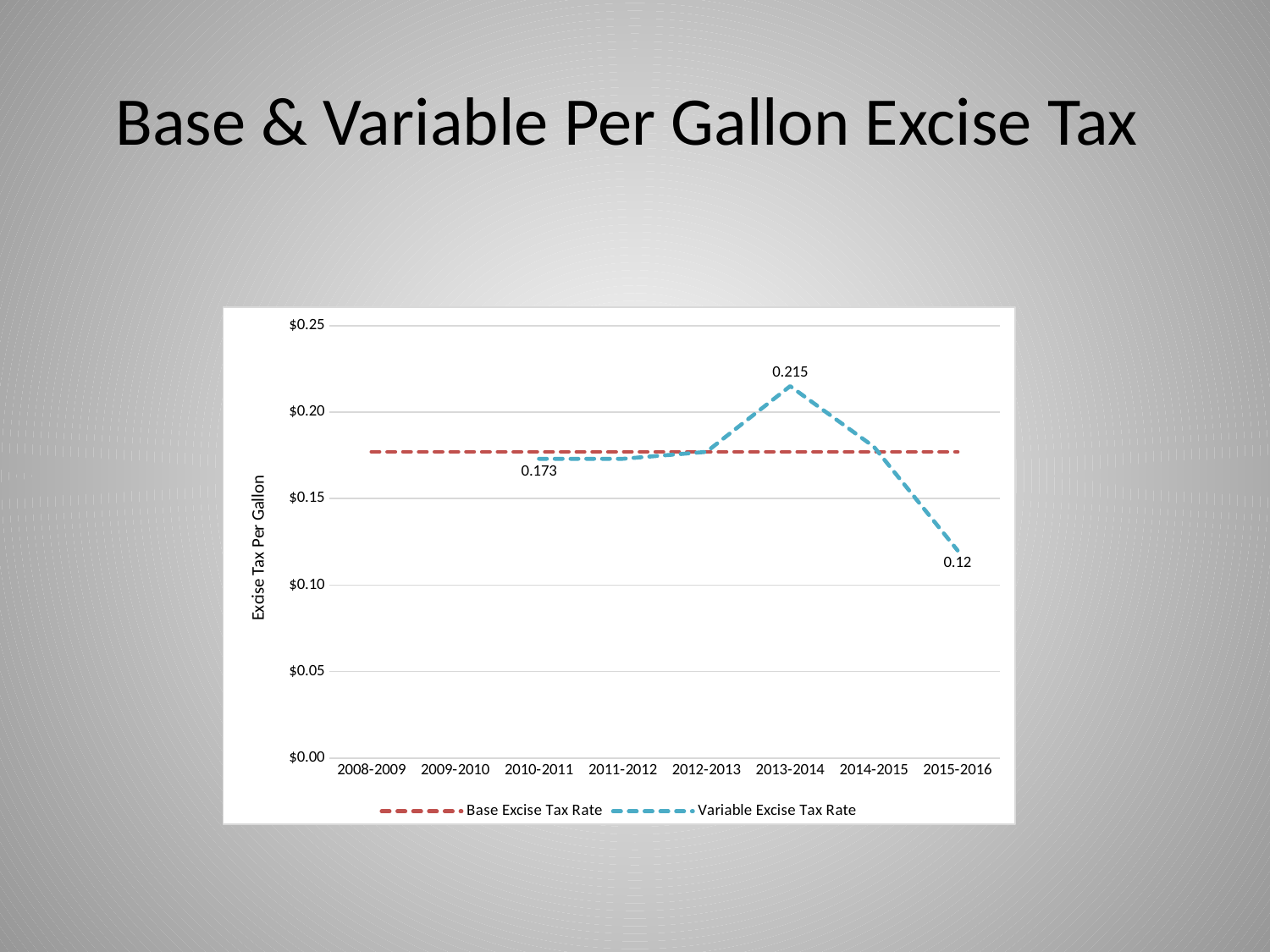
What is the Variable Excise Tax Rate for 2015-2016? 0.12 In which period is the Variable Excise Tax Rate highest? 2013-2014 Which is larger, the Variable Excise Tax Rate in 2010-2011 or in 2013-2014? 2013-2014 What is the Variable Excise Tax Rate for 2013-2014? 0.215 Is the Base Excise Tax Rate greater or less than $0.20? less How many periods are shown on the x axis? 8 What is the Variable Excise Tax Rate for 2010-2011? 0.173 What kind of chart is shown on the slide? line chart In which period is the Variable Excise Tax Rate lowest? 2015-2016 Does the Variable Excise Tax Rate rise or fall from 2013-2014 to 2015-2016? fall What is the difference between the Variable Excise Tax Rate in 2013-2014 and in 2015-2016? 0.095 How many series does the legend list? 2